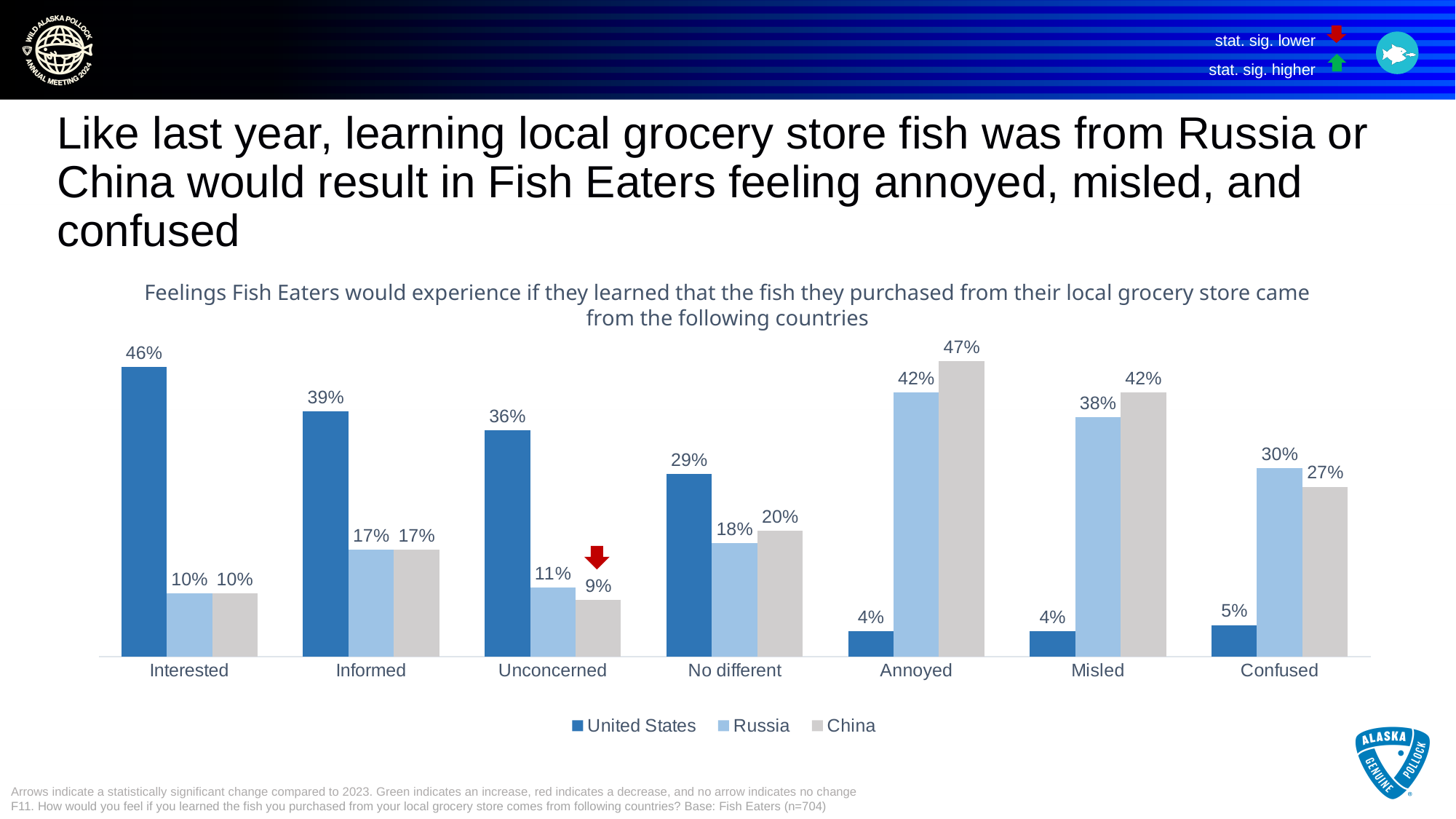
What percentage of Fish Eaters would feel Interested if the fish came from the United States? 46% In the Confused category, which is larger: the value for Russia or the value for China? Russia What kind of chart is shown on the slide? Bar chart Which feeling has the highest value for the United States series? Interested What is the value for China in the Annoyed category? 47% How many series does the legend list? 3 Which feeling has the lowest value for the China series? Unconcerned What is the difference between the China and United States values in the Misled category? 38 percentage points What is the value for Russia in the Misled category? 38% Which category has a red arrow indicating a statistically significant decrease? Unconcerned (China) How many feeling categories are shown on the x axis? 7 What is the difference between the United States and Russia values in the Informed category? 22 percentage points